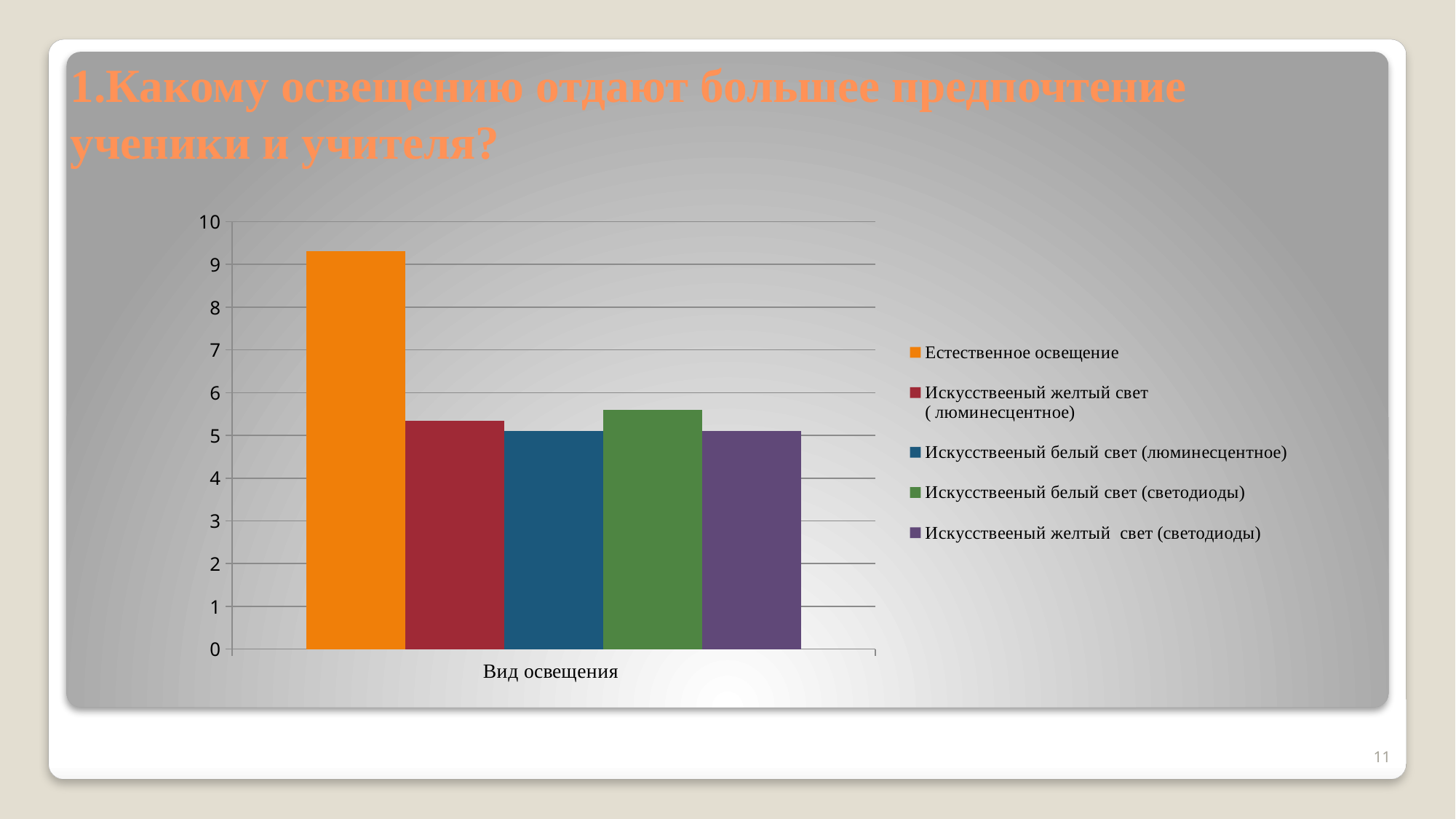
What colour is the bar for Естественное освещение? orange Which is larger: the value for Естественное освещение or the value for Искусствееный белый свет (светодиоды)? Естественное освещение Is the value for Естественное освещение greater or less than 8? greater What is the label on the x axis of the chart? Вид освещения How many categories are shown on the x axis? 1 Is the value for Искусствееный белый свет (люминесцентное) greater or less than 4? greater Is the value for Искусствееный белый свет (светодиоды) greater or less than 6? less What kind of chart is shown on the slide? bar chart Which is larger: the value for Естественное освещение or the value for Искусствееный желтый свет (светодиоды)? Естественное освещение How many series does the legend list? 5 Which series has the highest bar? Естественное освещение